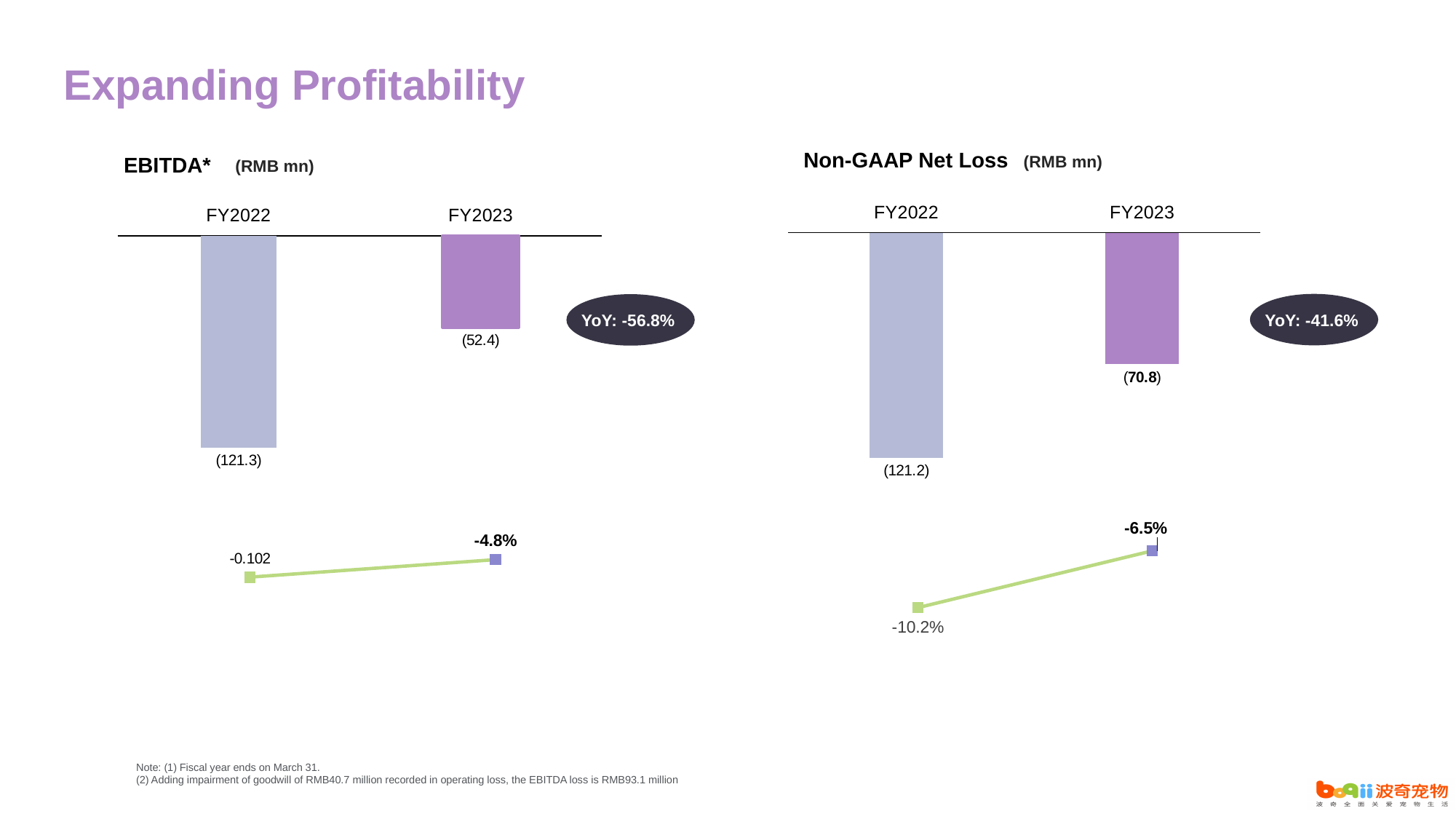
In the EBITDA chart, what is the year-over-year change shown in the callout? -56.8% In the Non-GAAP Net Loss chart, by how much did the loss shrink from FY2022 to FY2023 (in RMB mn)? 50.4 In the EBITDA chart, what is the value for FY2023? (52.4) In the Non-GAAP Net Loss chart, what is the value for FY2023? (70.8) In the EBITDA chart, by how much did the loss shrink from FY2022 to FY2023 (in RMB mn)? 68.9 In the Non-GAAP Net Loss chart, what is the value for FY2022? (121.2) In the line below the EBITDA chart, what is the FY2023 percentage value? -4.8% In the line below the Non-GAAP Net Loss chart, what is the FY2023 percentage value? -6.5% In the EBITDA chart, what is the value for FY2022? (121.3) In the Non-GAAP Net Loss chart, which year has the larger loss, FY2022 or FY2023? FY2022 What kind of chart is used to show the EBITDA values for FY2022 and FY2023? Bar chart In the Non-GAAP Net Loss chart, what is the year-over-year change shown in the callout? -41.6%